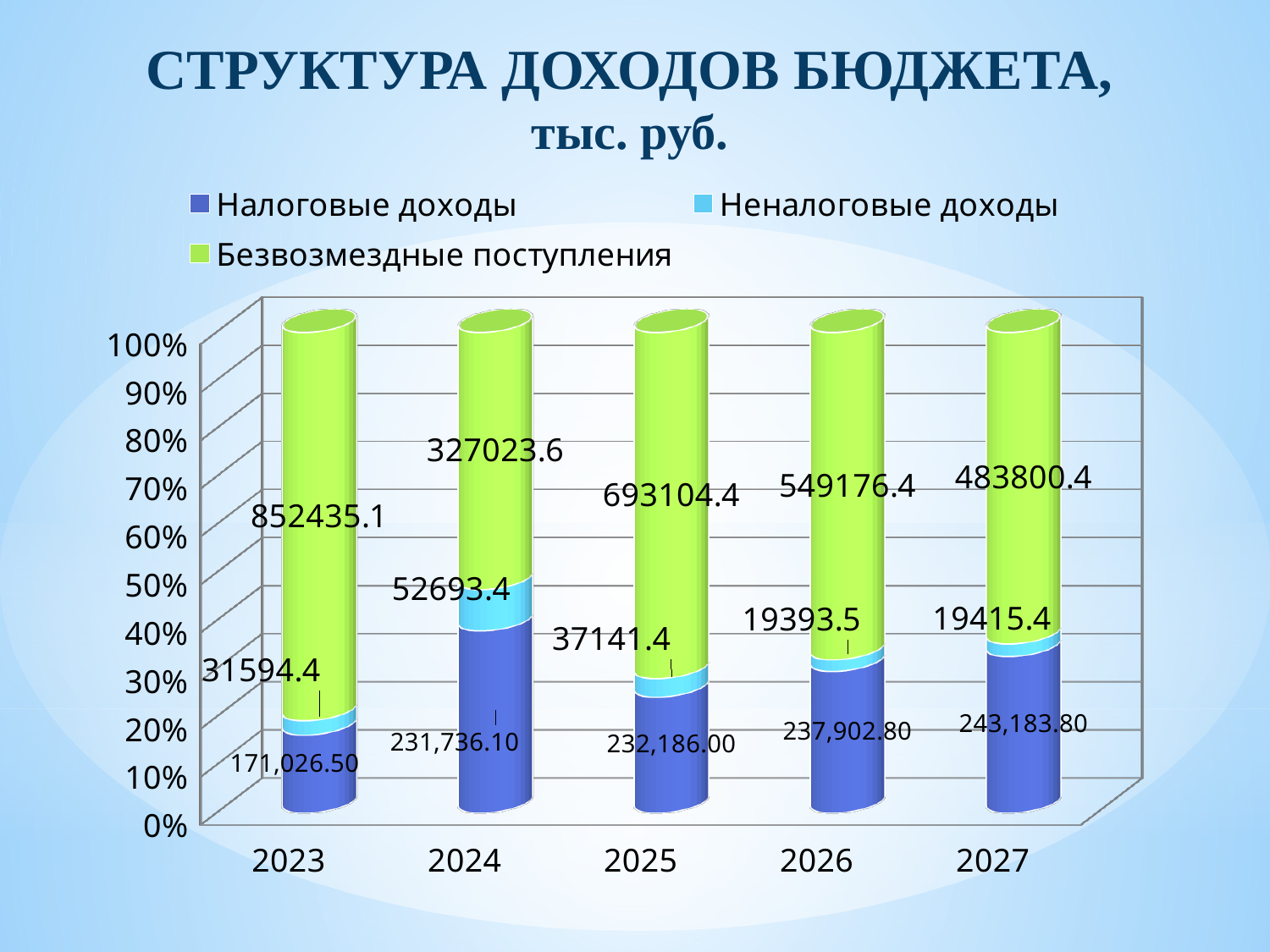
What is the value of Неналоговые доходы for 2024? 52693.4 In which year is Неналоговые доходы highest? 2024 What is the difference between Налоговые доходы in 2027 and in 2023? 72,157.30 How many series does the legend list? 3 How many years are shown on the x axis? 5 What kind of chart is shown on the slide? stacked bar chart Do the values of Налоговые доходы rise or fall from 2023 to 2027? rise Which is larger: Безвозмездные поступления in 2026 or in 2027? 2026 In which year is Налоговые доходы lowest? 2023 What is the value of Налоговые доходы for 2023? 171,026.50 In which year is Безвозмездные поступления highest? 2023 What is the value of Безвозмездные поступления for 2025? 693104.4